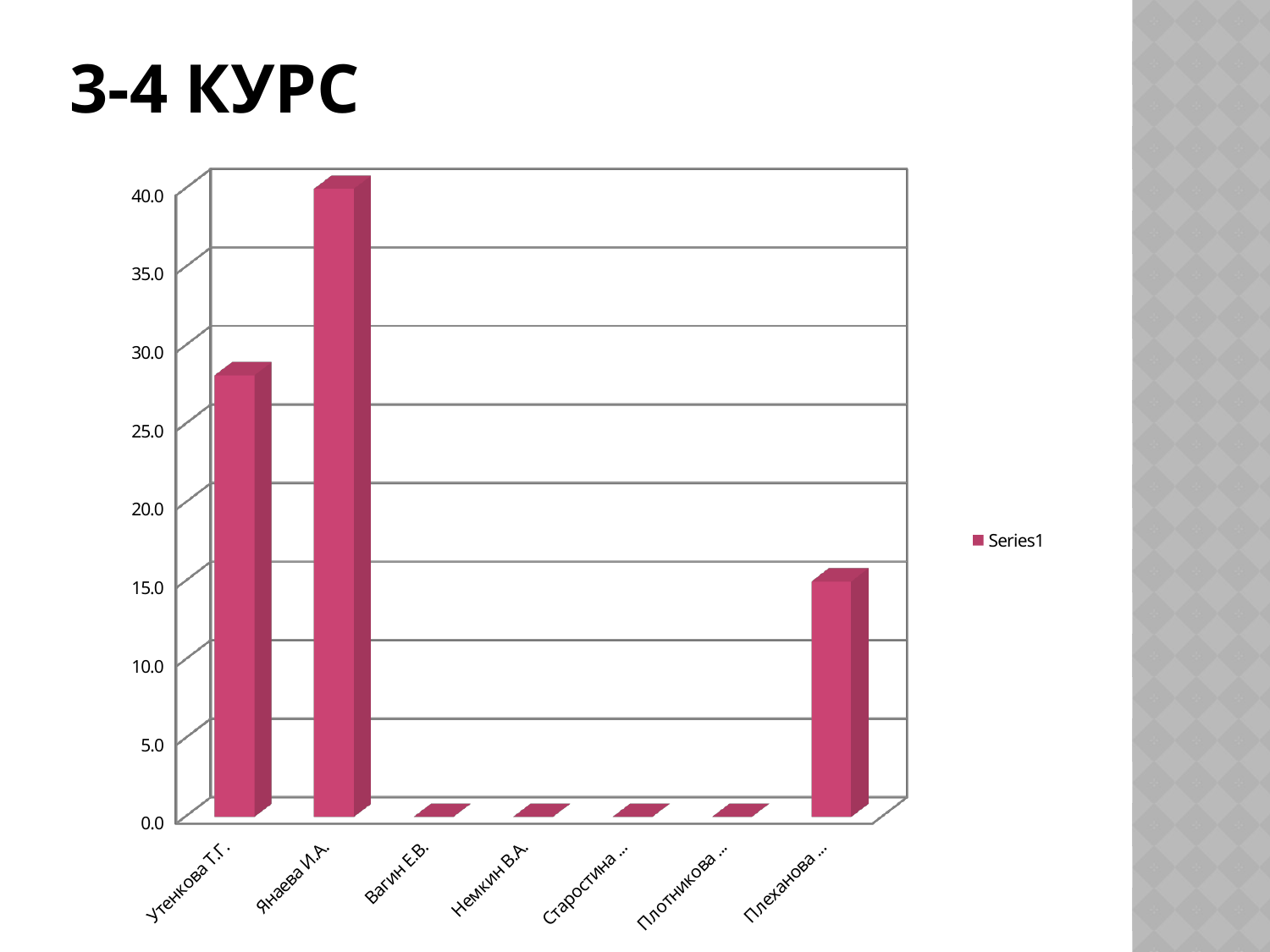
What kind of chart is shown on the slide? bar chart Is the value for Плеханова greater or less than 10.0? greater Is the value for Янаева И.А. greater or less than 35.0? greater How many categories are shown along the x axis of the chart? 7 Which category has the highest bar in the chart? Янаева И.А. What is the value for Вагин Е.В. in the chart? 0.0 Is the value for Утенкова Т.Г. greater or less than 30.0? less How many series does the chart legend list? 1 Which is larger, the value for Утенкова Т.Г. or the value for Плеханова? Утенкова Т.Г. What is the name of the series shown in the chart legend? Series1 Which is larger, the value for Янаева И.А. or the value for Утенкова Т.Г.? Янаева И.А.